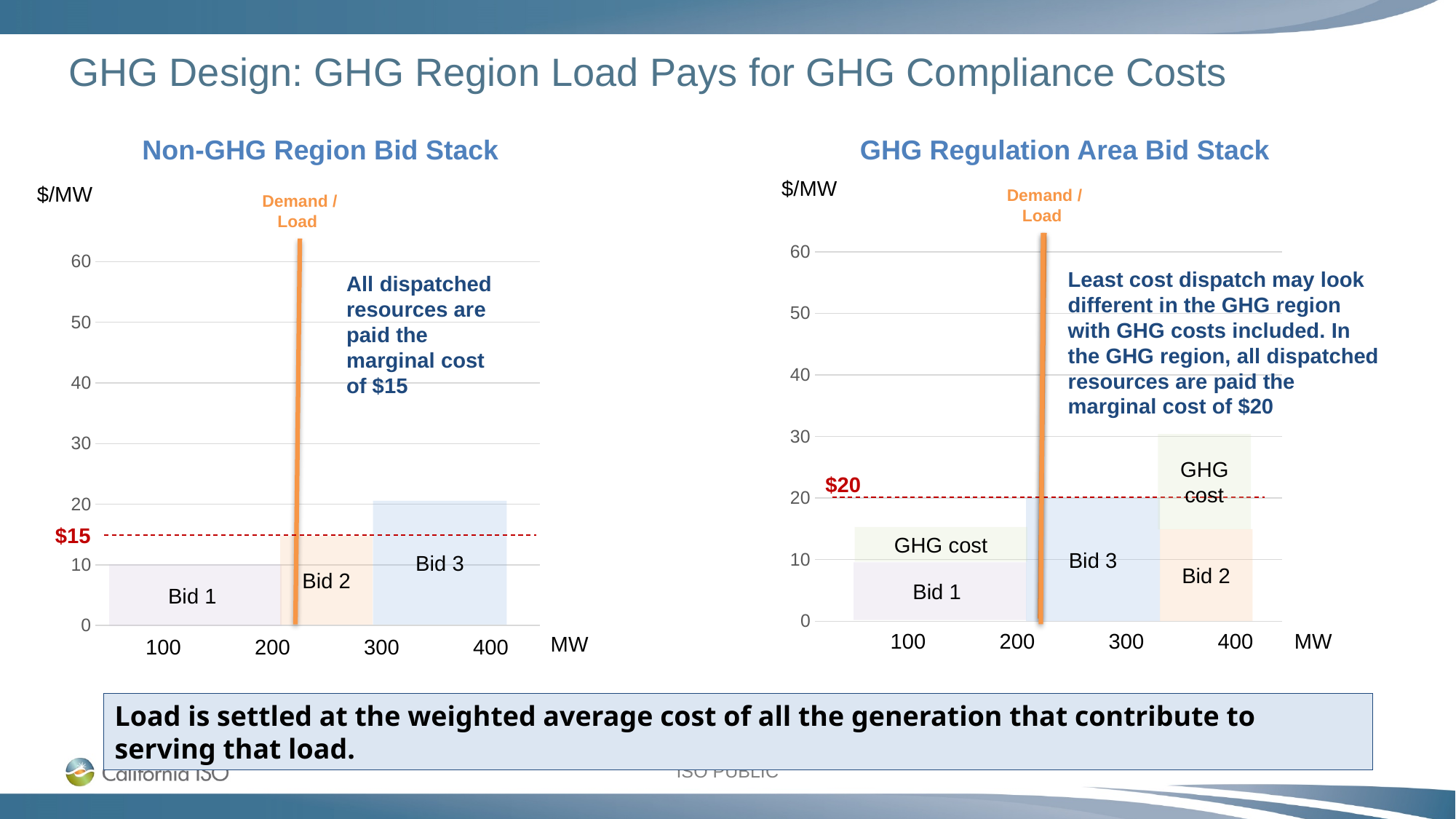
In the Non-GHG Region Bid Stack, what is the marginal cost that all dispatched resources are paid? $15 In the Non-GHG Region Bid Stack, which bid has the lowest price? Bid 1 In the GHG Regulation Area Bid Stack, which is larger, Bid 3 or Bid 1? Bid 3 What is the unit shown on the x axis of both charts? MW In the GHG Regulation Area Bid Stack, is the top of Bid 2 including GHG cost greater or less than 20? greater In the GHG Regulation Area Bid Stack, is the value for Bid 3 greater or less than 10? greater What kind of chart is the Non-GHG Region Bid Stack? bar chart In the Non-GHG Region Bid Stack, how many bids are shown? 3 In the Non-GHG Region Bid Stack, which bid has the highest price? Bid 3 In the Non-GHG Region Bid Stack, is the value for Bid 1 greater or less than 20? less In the GHG Regulation Area Bid Stack, what is the marginal cost that all dispatched resources are paid? $20